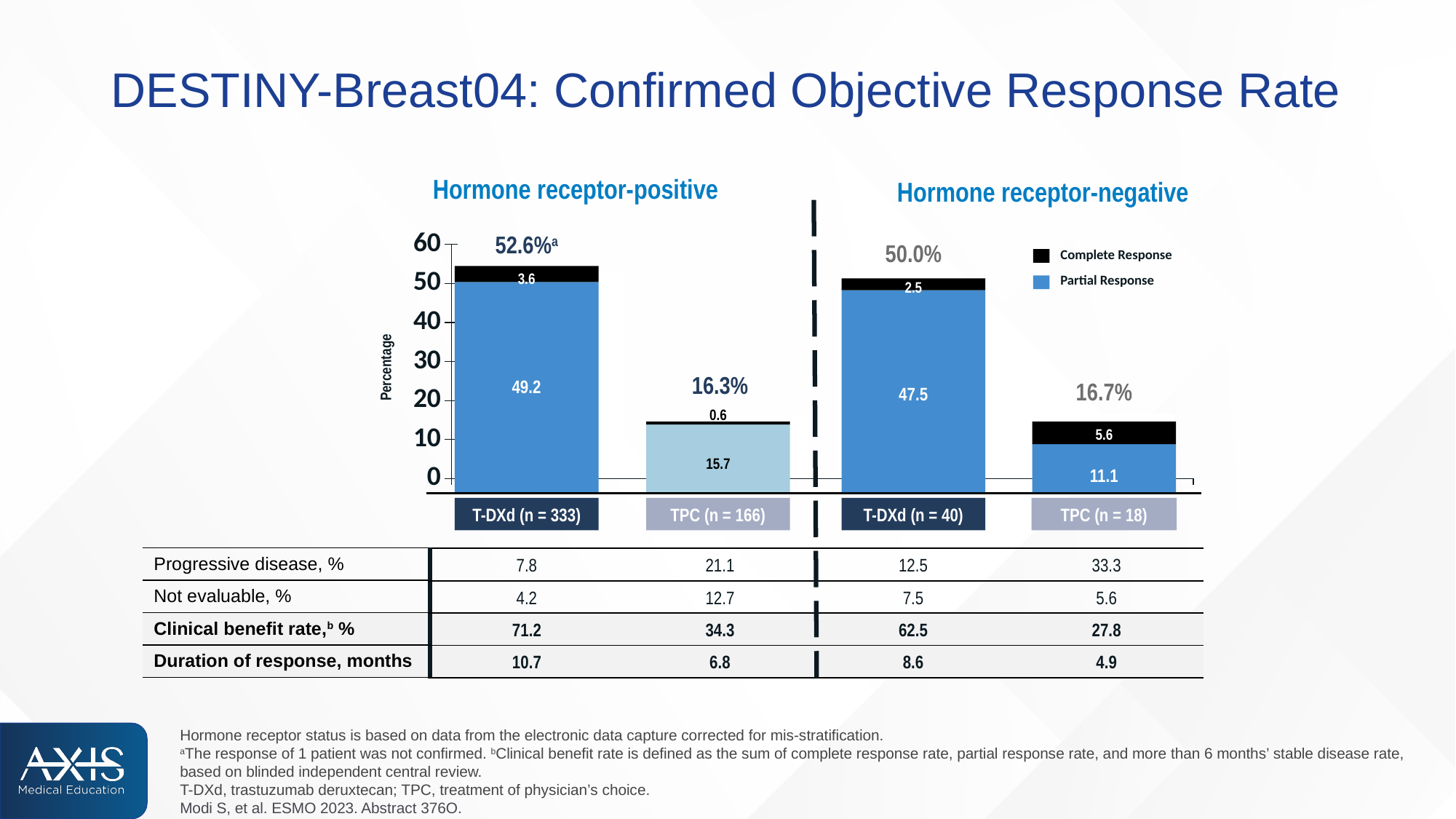
What is the label on the vertical axis of the chart? Percentage In the Hormone receptor-positive panel, what is the difference between the total response rates of T-DXd (n = 333) and TPC (n = 166)? 36.3 percentage points In the Hormone receptor-positive panel, what is the partial response value for T-DXd (n = 333)? 49.2 How many series does the chart legend list? 2 What is the total confirmed objective response rate shown above the T-DXd (n = 333) bar in the Hormone receptor-positive panel? 52.6% Across both panels, which bar has the lowest total objective response rate? TPC (n = 166) In the Hormone receptor-negative panel, what is the complete response value for TPC (n = 18)? 5.6 What kind of chart is shown on the slide? Stacked bar chart What is the total confirmed objective response rate shown above the TPC (n = 18) bar in the Hormone receptor-negative panel? 16.7% In the Hormone receptor-positive panel, what is the complete response value for TPC (n = 166)? 0.6 Which has the larger total objective response rate: T-DXd (n = 333) in the Hormone receptor-positive panel or T-DXd (n = 40) in the Hormone receptor-negative panel? T-DXd (n = 333) Across both panels, which bar has the highest total objective response rate? T-DXd (n = 333)